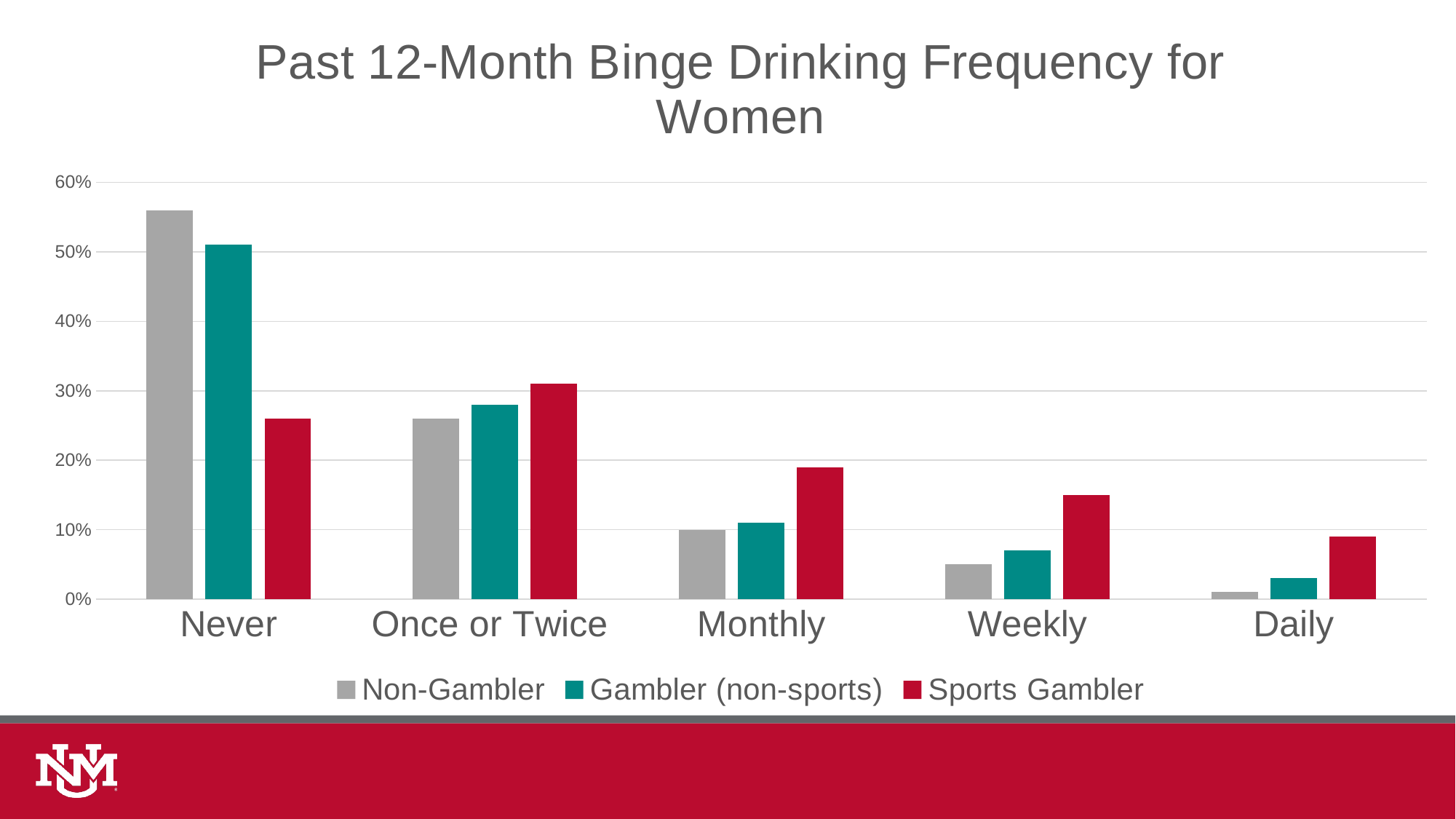
Which is larger for Once or Twice: the Non-Gambler value or the Sports Gambler value? Sports Gambler How many frequency categories are shown on the x axis? 5 Which series has the tallest bar in the Daily category? Sports Gambler What kind of chart is shown on the slide? Bar chart Which series has the tallest bar in the Never category? Non-Gambler Is the Sports Gambler value for Never greater or less than 30%? less Is the Non-Gambler value for Never greater or less than 50%? greater Which category has the lowest Non-Gambler value? Daily How many series does the legend list? 3 Do the Non-Gambler values rise or fall from Never to Daily? Fall Is the Sports Gambler value for Weekly greater or less than 10%? greater What colour represents the Sports Gambler series? Red